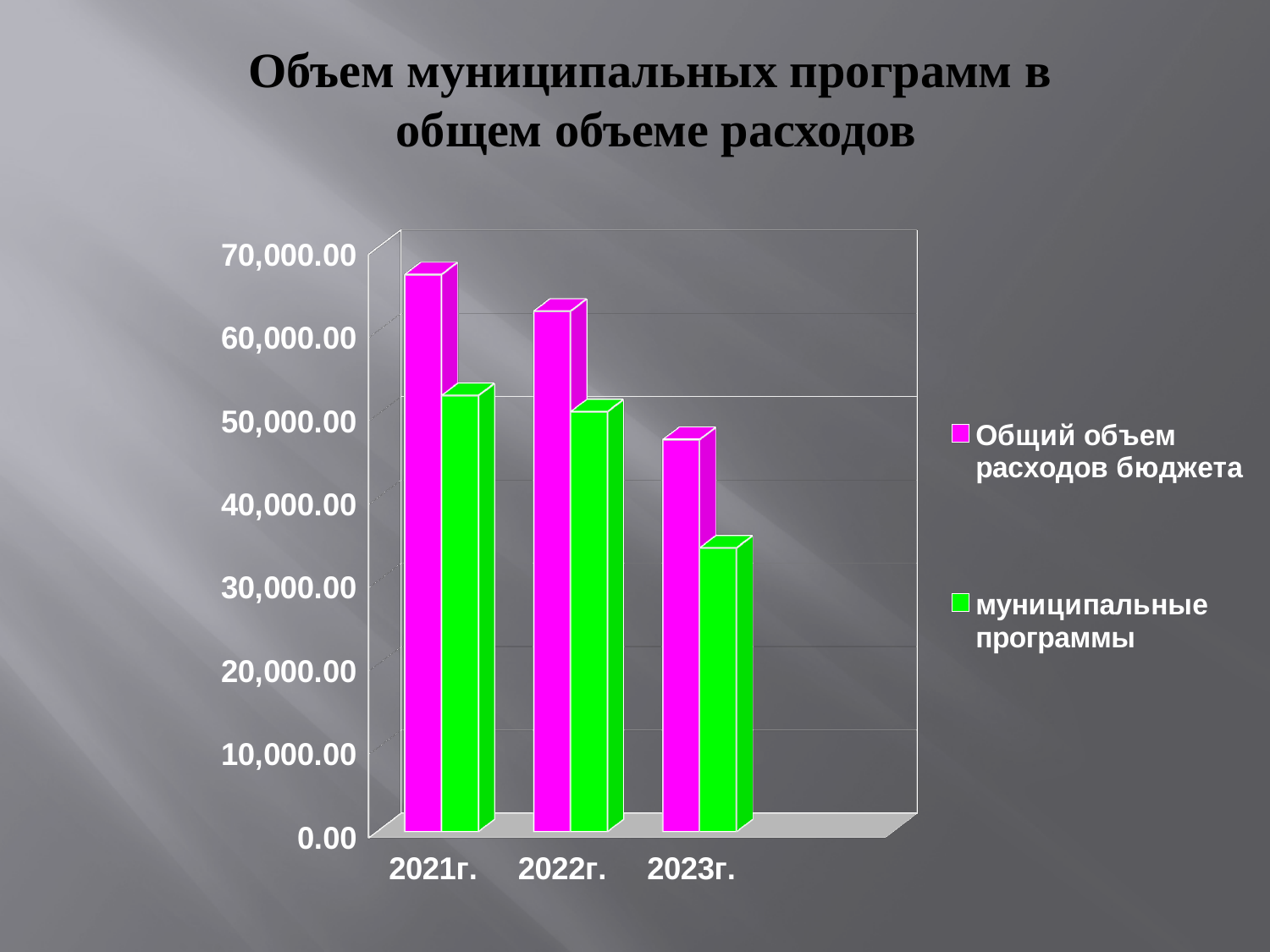
Which year has the larger value for "Общий объем расходов бюджета": 2021г. or 2023г.? 2021г. In which year is the value for "Общий объем расходов бюджета" the highest? 2021г. Is the value for "муниципальные программы" in 2022г. greater or less than 40,000.00? greater How many series does the legend list? 2 Is the value for "Общий объем расходов бюджета" in 2021г. greater or less than 60,000.00? greater Which colour represents "муниципальные программы" in the legend? green What kind of chart is shown on the slide? bar chart In which year is the value for "муниципальные программы" the lowest? 2023г. Do the values for "Общий объем расходов бюджета" rise or fall from 2021г. to 2023г.? fall Which year has the larger value for "муниципальные программы": 2022г. or 2023г.? 2022г. Is the value for "муниципальные программы" in 2023г. greater or less than 40,000.00? less How many years (categories) are shown on the x axis? 3